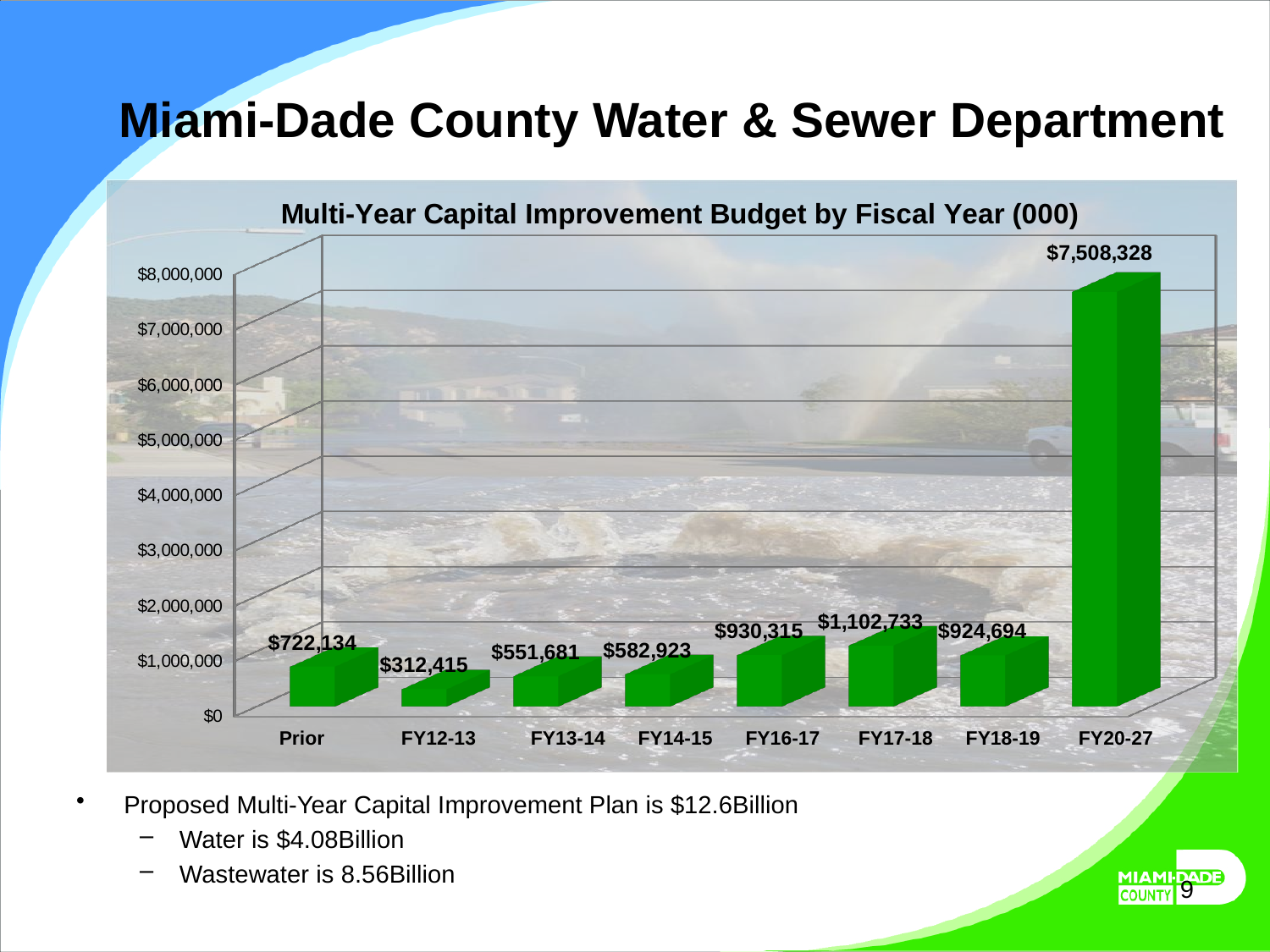
How many fiscal year categories are shown on the x axis? 8 What is the value for the Prior category? $722,134 What is the value for FY17-18? $1,102,733 What is the value for FY20-27? $7,508,328 Which fiscal year has the highest budget? FY20-27 What is the difference between the FY20-27 value and the FY17-18 value? $6,405,595 Is the value for FY20-27 greater or less than $8,000,000? less Which fiscal year has the lowest budget? FY12-13 What is the difference between the Prior value and the FY12-13 value? $409,719 What is the value for FY12-13? $312,415 Which is larger, the value for Prior or the value for FY14-15? Prior What kind of chart is shown on the slide? Bar chart